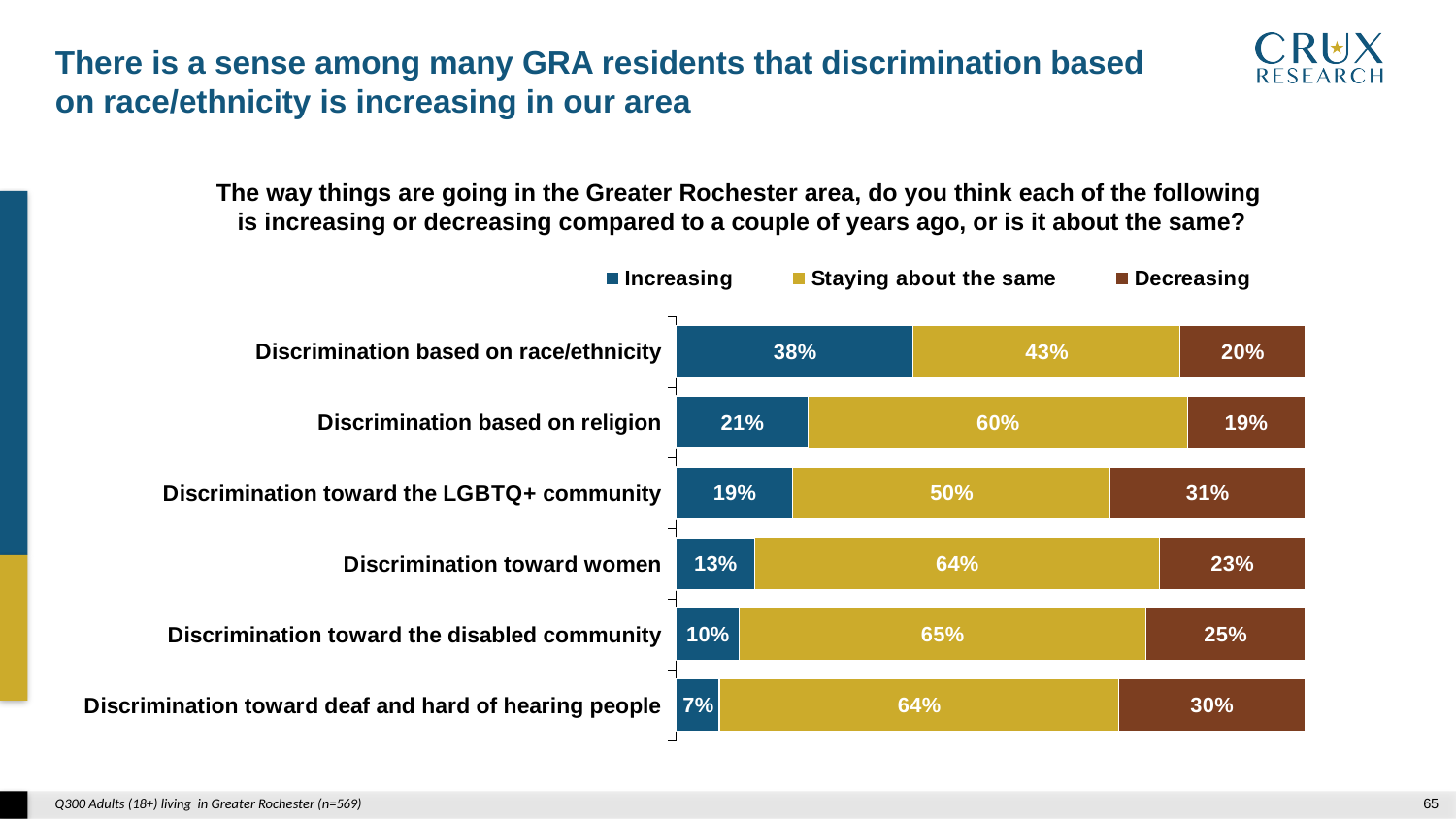
Which is larger: the 'Decreasing' percentage for discrimination toward women or for discrimination toward the disabled community? Discrimination toward the disabled community How many discrimination categories are shown in the chart? 6 What percentage of respondents say discrimination based on race/ethnicity is increasing? 38% How many series does the legend list? 3 Which category has the lowest 'Increasing' percentage? Discrimination toward deaf and hard of hearing people Which legend entry is shown in yellow? Staying about the same What percentage say discrimination toward the LGBTQ+ community is decreasing? 31% What is the total of the three segments for the 'Discrimination based on religion' bar? 100% What percentage say discrimination toward the disabled community is staying about the same? 65% What is the difference between the 'Increasing' percentages for discrimination based on race/ethnicity and discrimination based on religion? 17% Which category has the highest 'Increasing' percentage? Discrimination based on race/ethnicity What kind of chart is shown on the slide? Stacked bar chart